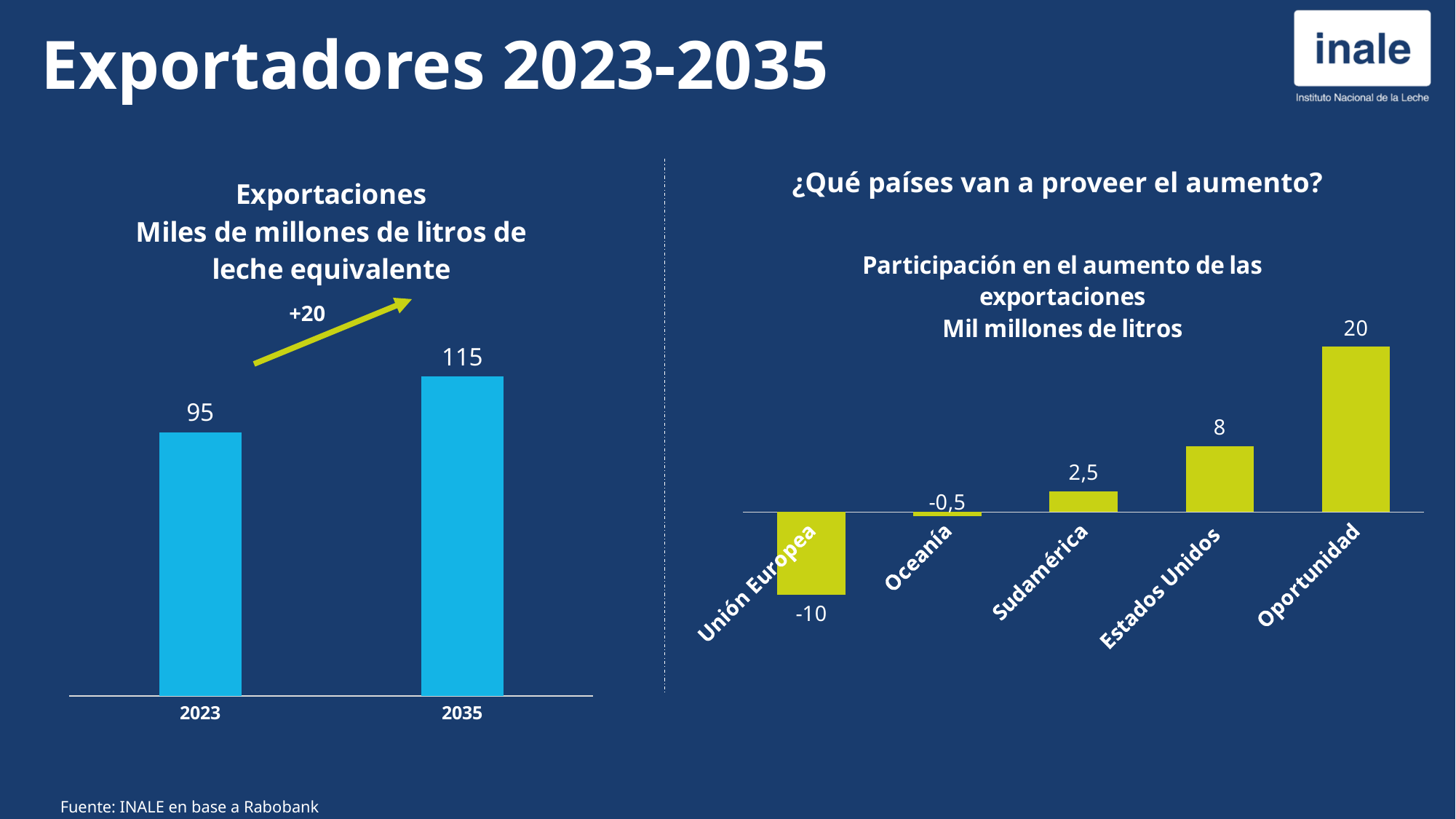
In the right chart (Participación en el aumento de las exportaciones), which category has the lowest value? Unión Europea In the left chart (Exportaciones), do the values rise or fall from 2023 to 2035? rise What kind of chart is the left chart (Exportaciones)? bar chart In the right chart (Participación en el aumento de las exportaciones), how many categories are shown? 5 In the left chart (Exportaciones), what is the value for 2035? 115 In the left chart (Exportaciones), what is the value for 2023? 95 In the right chart (Participación en el aumento de las exportaciones), which category has the highest value? Oportunidad In the right chart (Participación en el aumento de las exportaciones), which is larger, the value for Estados Unidos or the value for Oceanía? Estados Unidos In the left chart (Exportaciones), what is the difference between the 2035 and 2023 values? 20 In the left chart (Exportaciones), how many bars are plotted? 2 In the right chart (Participación en el aumento de las exportaciones), what is the value for Unión Europea? -10 In the right chart (Participación en el aumento de las exportaciones), what is the value for Sudamérica? 2,5